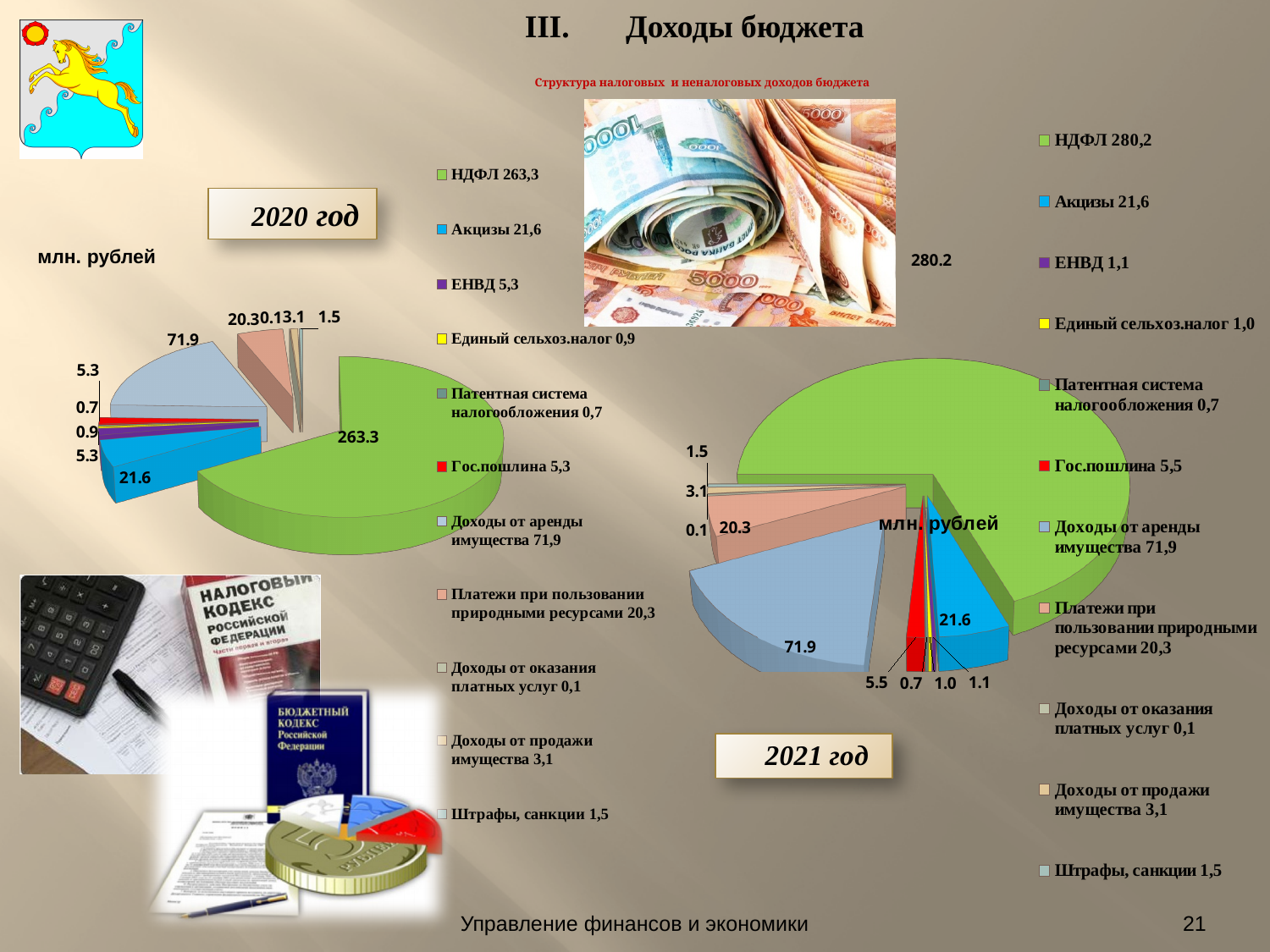
In what units are the values in the 2020 год chart given, according to the label next to it? млн. рублей What kind of chart is the 2020 год chart? pie chart In the 2021 год chart, what is the value for НДФЛ? 280.2 In the 2021 год chart, what is the value for Гос.пошлина? 5.5 In the 2021 год chart, which category has the smallest value? Доходы от оказания платных услуг How much larger is the НДФЛ value in the 2021 год chart than in the 2020 год chart? 16.9 In the 2020 год chart, which category has the largest slice? НДФЛ In the 2020 год chart, what is the value for НДФЛ? 263.3 In the 2020 год chart, which is larger: Доходы от аренды имущества or Акцизы? Доходы от аренды имущества How many data series does the 2021 год chart plot? 1 In the 2021 год chart, what is the difference between Гос.пошлина and ЕНВД? 4.4 How many categories does the 2020 год chart show? 11